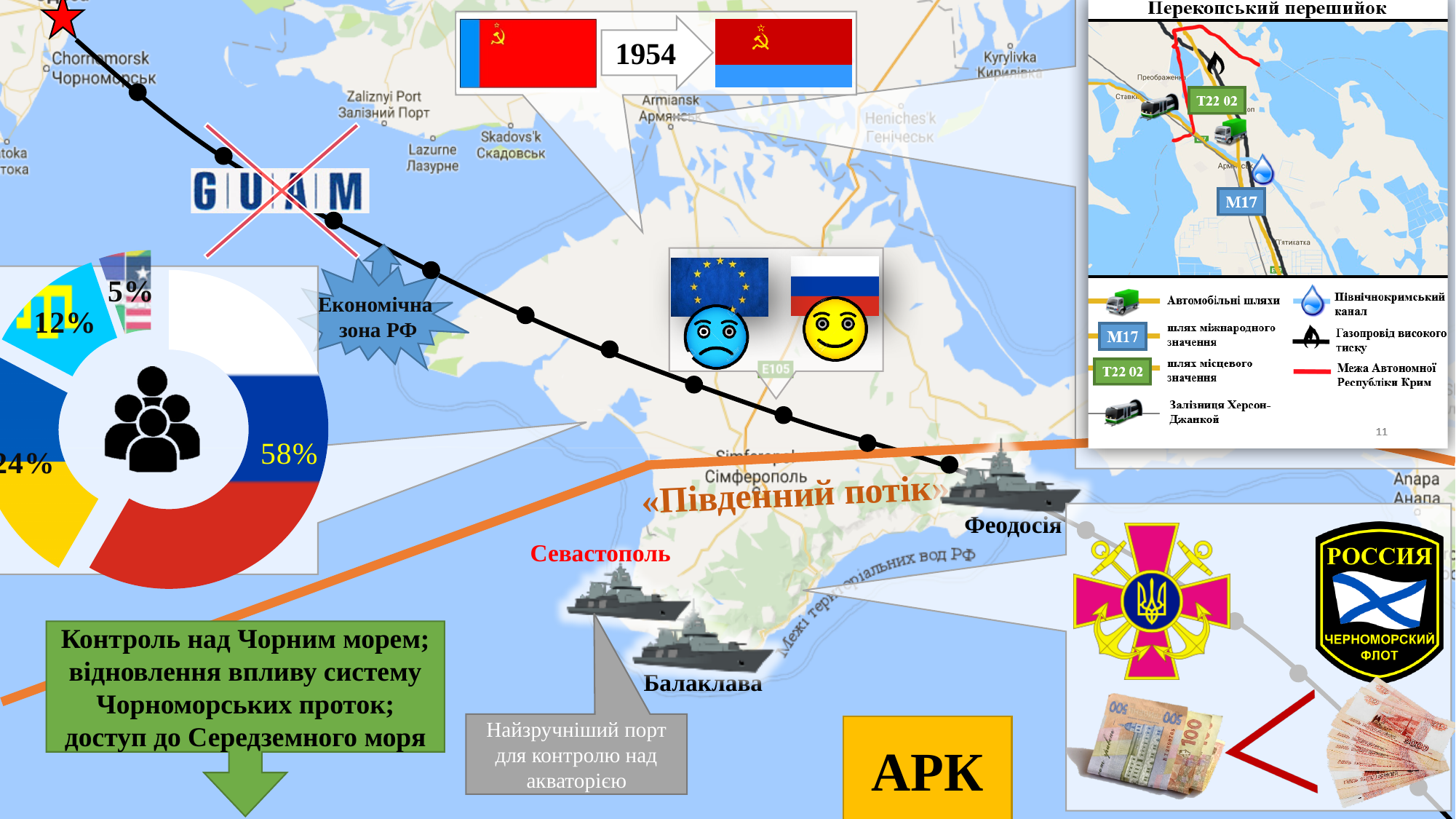
In the pie chart, what value is shown on the light-blue slice with the Crimean Tatar flag? 12% What kind of chart is shown on the left side of the slide? doughnut chart What icon is placed in the centre of the pie chart? a group of people icon Is the largest slice of the pie chart greater or less than 50%? greater In the pie chart, what value is shown on the slice coloured with the Russian flag (white, blue, red)? 58% Which is larger in the pie chart: the light-blue slice or the slice labelled 5%? the light-blue slice (12%) What is the value of the smallest slice in the pie chart? 5% What is the difference between the 58% slice and the 24% slice in the pie chart? 34% What is the value of the largest slice in the pie chart? 58% In the pie chart, what value is shown on the slice coloured with the Ukrainian flag (blue and yellow)? 24% How many slices does the pie chart on the left have? 4 What share of the pie does the slice with the Russian flag colours represent? 58%